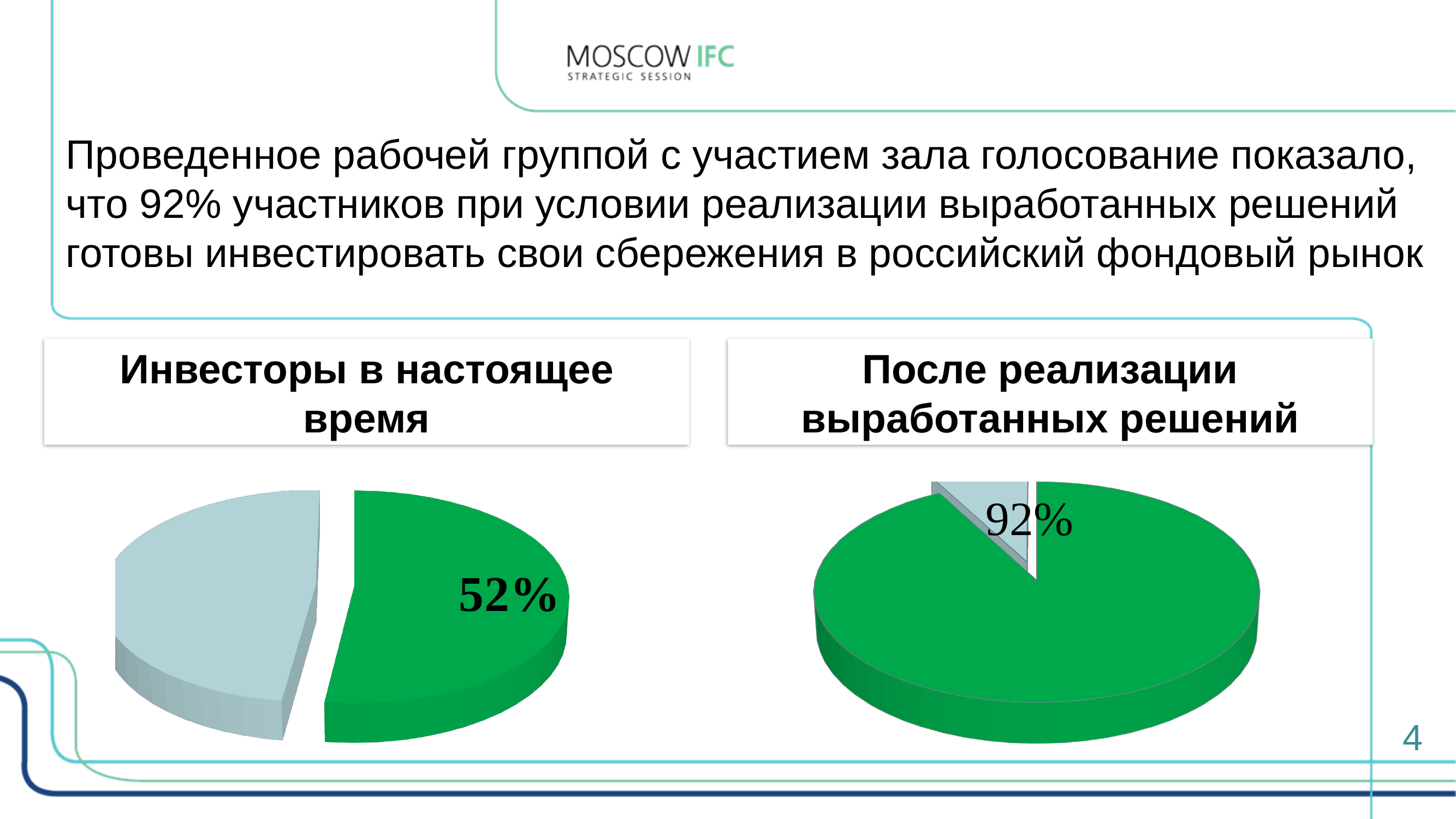
How many slices does the right chart "После реализации выработанных решений" have? 2 What kind of chart is the left chart titled "Инвесторы в настоящее время"? pie chart In the right chart "После реализации выработанных решений", what value is printed on the green slice? 92% What is the title of the left chart? Инвесторы в настоящее время How many slices does the left chart "Инвесторы в настоящее время" have? 2 In the right chart "После реализации выработанных решений", is the light blue slice greater or less than 25%? less Which chart has the larger green slice, the left one ("Инвесторы в настоящее время") or the right one ("После реализации выработанных решений")? the right one (После реализации выработанных решений) What is the title of the right chart? После реализации выработанных решений In the right chart "После реализации выработанных решений", which slice is larger, the green one or the light blue one? the green one What kind of chart is the right chart titled "После реализации выработанных решений"? pie chart What is the difference between the green slice value in the right chart (92%) and the green slice value in the left chart (52%)? 40% In the left chart "Инвесторы в настоящее время", what value is printed on the green slice? 52%